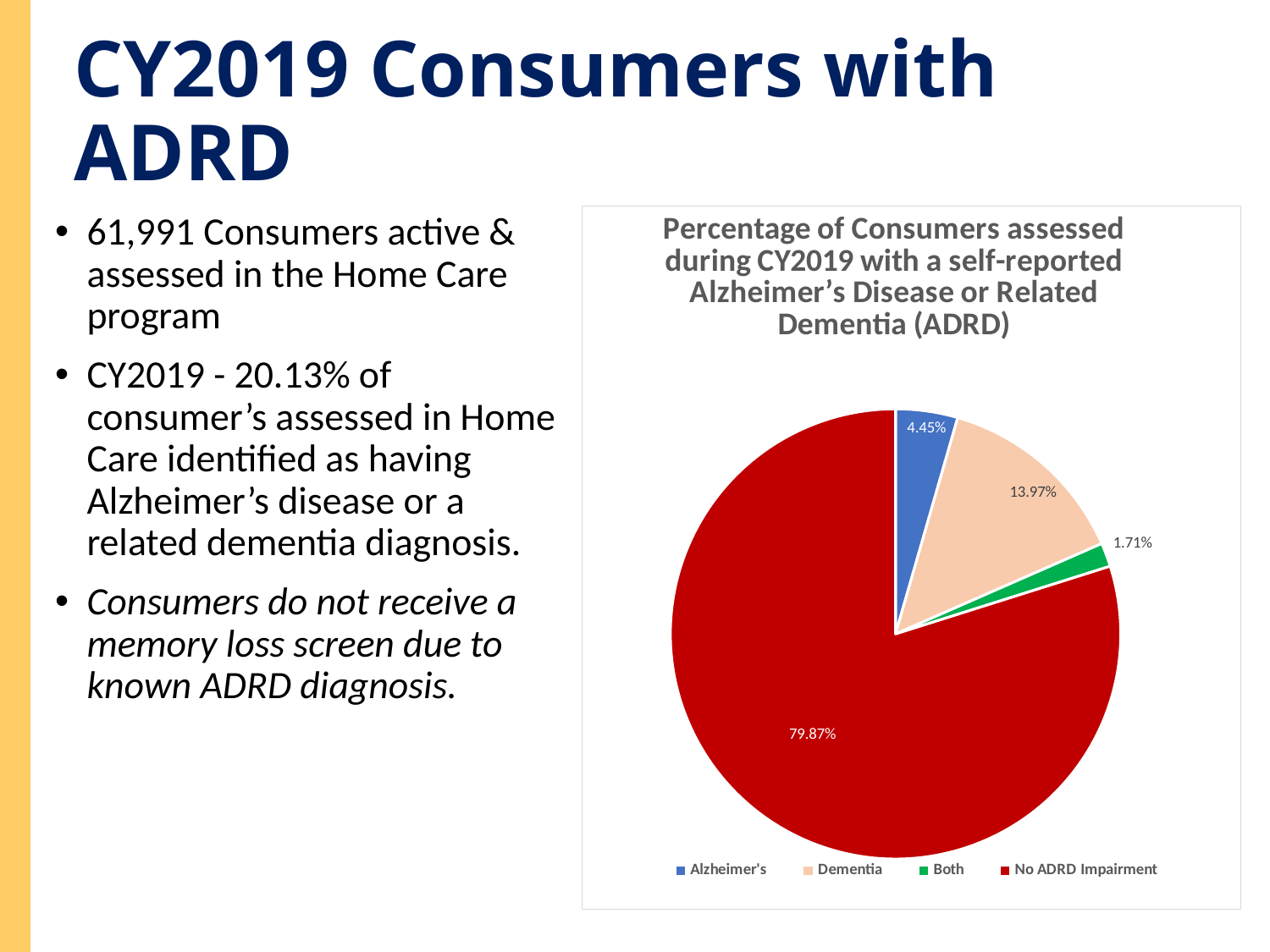
What is the title of the pie chart? Percentage of Consumers assessed during CY2019 with a self-reported Alzheimer's Disease or Related Dementia (ADRD) What is the difference in percentage points between the Dementia slice and the Alzheimer's slice? 9.52 What colour is the No ADRD Impairment slice in the pie chart? Red Which category has the smallest slice of the pie chart? Both What percentage of the pie chart is labelled for Both? 1.71% Which category has the largest slice of the pie chart? No ADRD Impairment What type of chart is shown on the slide? Pie chart What percentage of the pie chart is labelled for Alzheimer's? 4.45% What percentage of the pie chart is labelled for No ADRD Impairment? 79.87% What percentage of the pie chart is labelled for Dementia? 13.97% How many categories does the pie chart legend list? 4 Which slice is larger, Alzheimer's or Dementia? Dementia